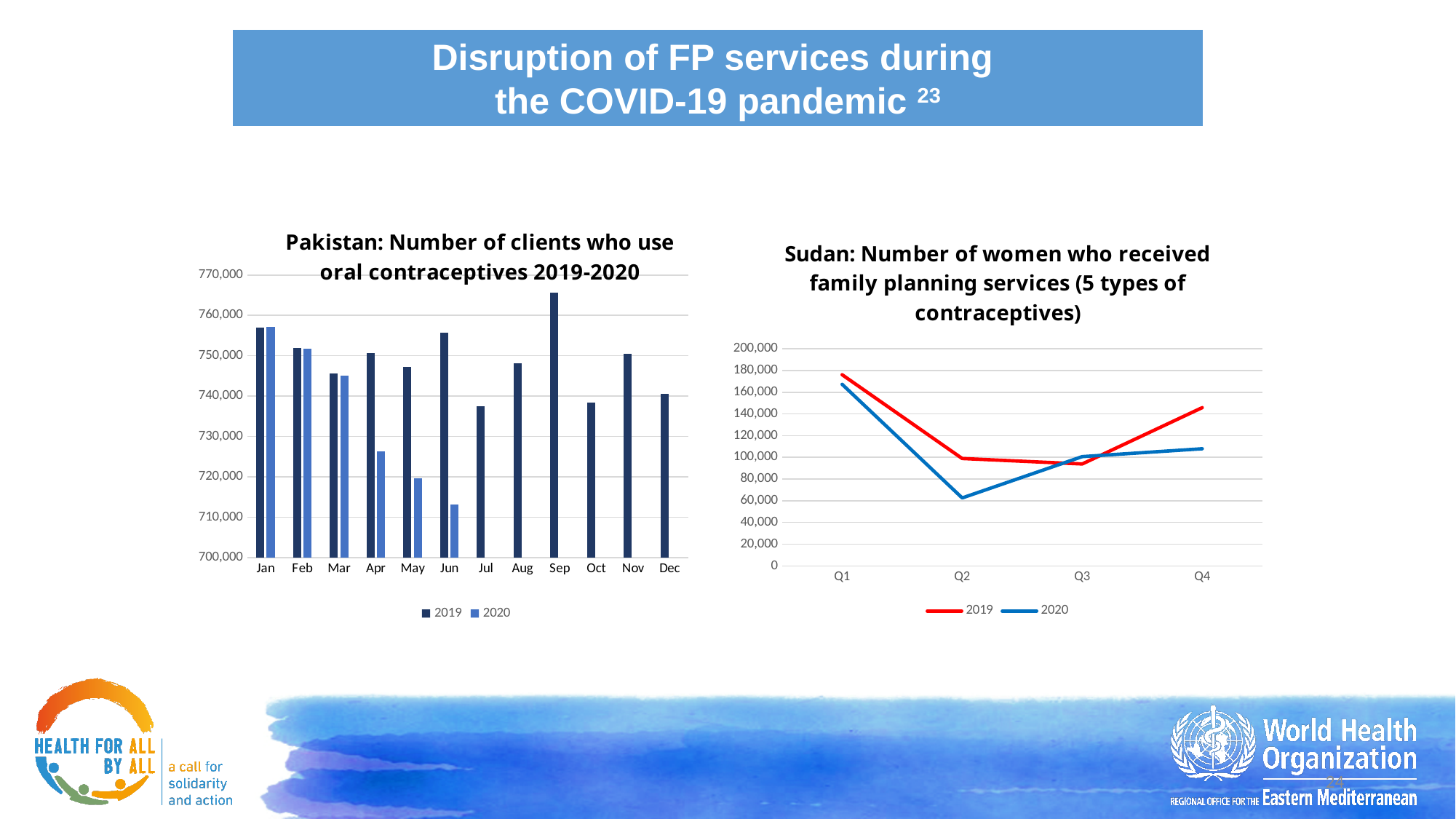
On the Pakistan chart, is the value for Sep 2019 greater or less than 760,000? greater On the Pakistan chart, how many months are shown on the x axis? 12 On the Sudan chart, is the 2020 value for Q2 greater or less than 80,000? less On the Pakistan chart, which month has the lowest value for 2020? Jun On the Sudan chart, does the 2020 line rise or fall from Q2 to Q4? rise On the Sudan chart, what kind of chart is used? line chart On the Pakistan chart, how many series does the legend list? 2 On the Pakistan chart, which month has the highest value for 2019? Sep On the Pakistan chart, is the value for Jun 2020 greater or less than 720,000? less On the Pakistan chart, what kind of chart is used? bar chart On the Sudan chart, which is larger in Q4, the 2019 value or the 2020 value? 2019 On the Sudan chart, which quarter has the lowest value for 2020? Q2